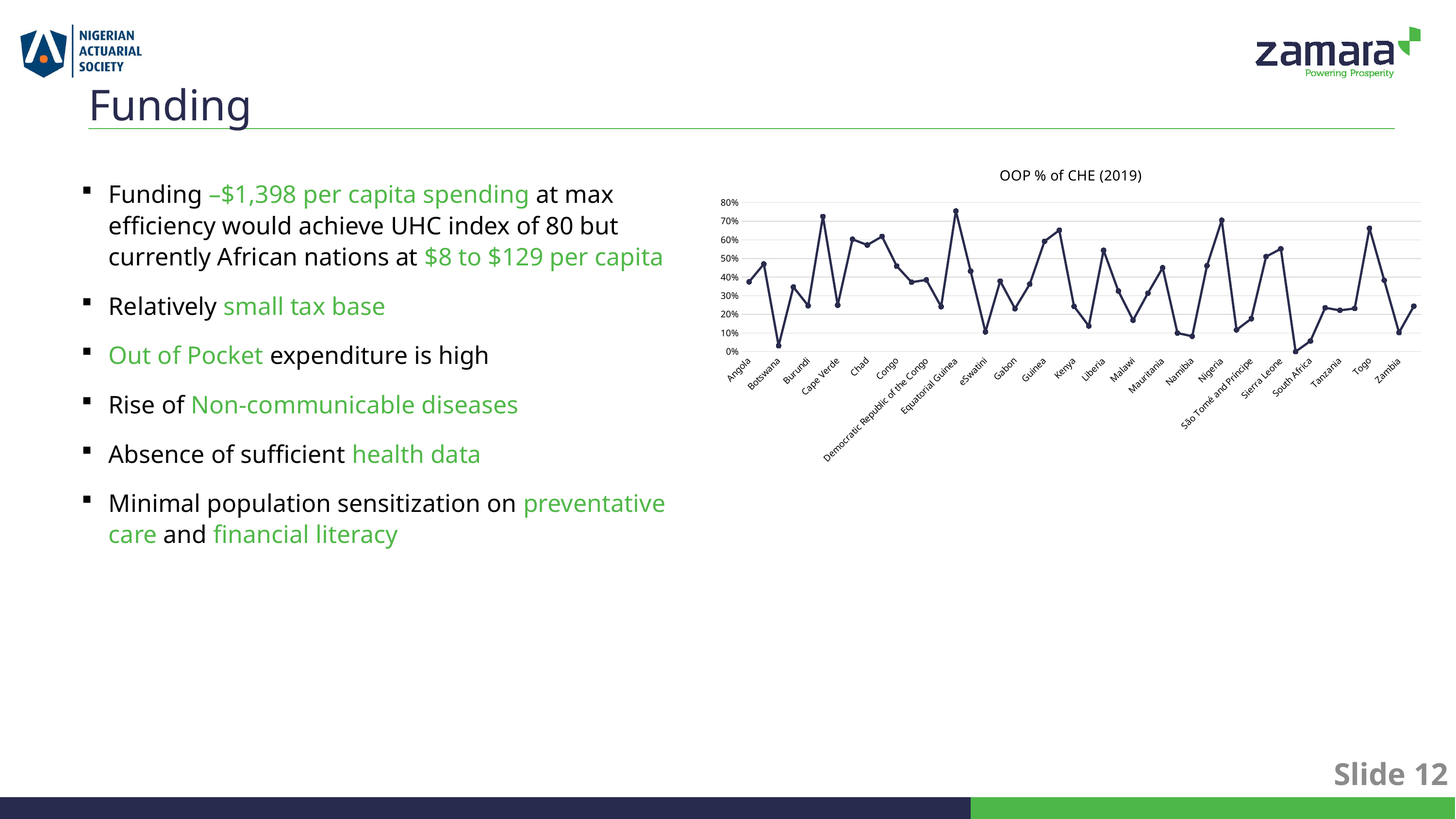
Is the value for Nigeria greater or less than 60%? greater What kind of chart is shown on the slide? line chart Is the value for Chad greater or less than 50%? greater Is the value for Togo greater or less than 60%? greater Which has the higher OOP % of CHE, Nigeria or Botswana? Nigeria Which has the higher OOP % of CHE, Equatorial Guinea or Kenya? Equatorial Guinea What is the title of the chart on the slide? OOP % of CHE (2019) Which has the lower OOP % of CHE, South Africa or Togo? South Africa